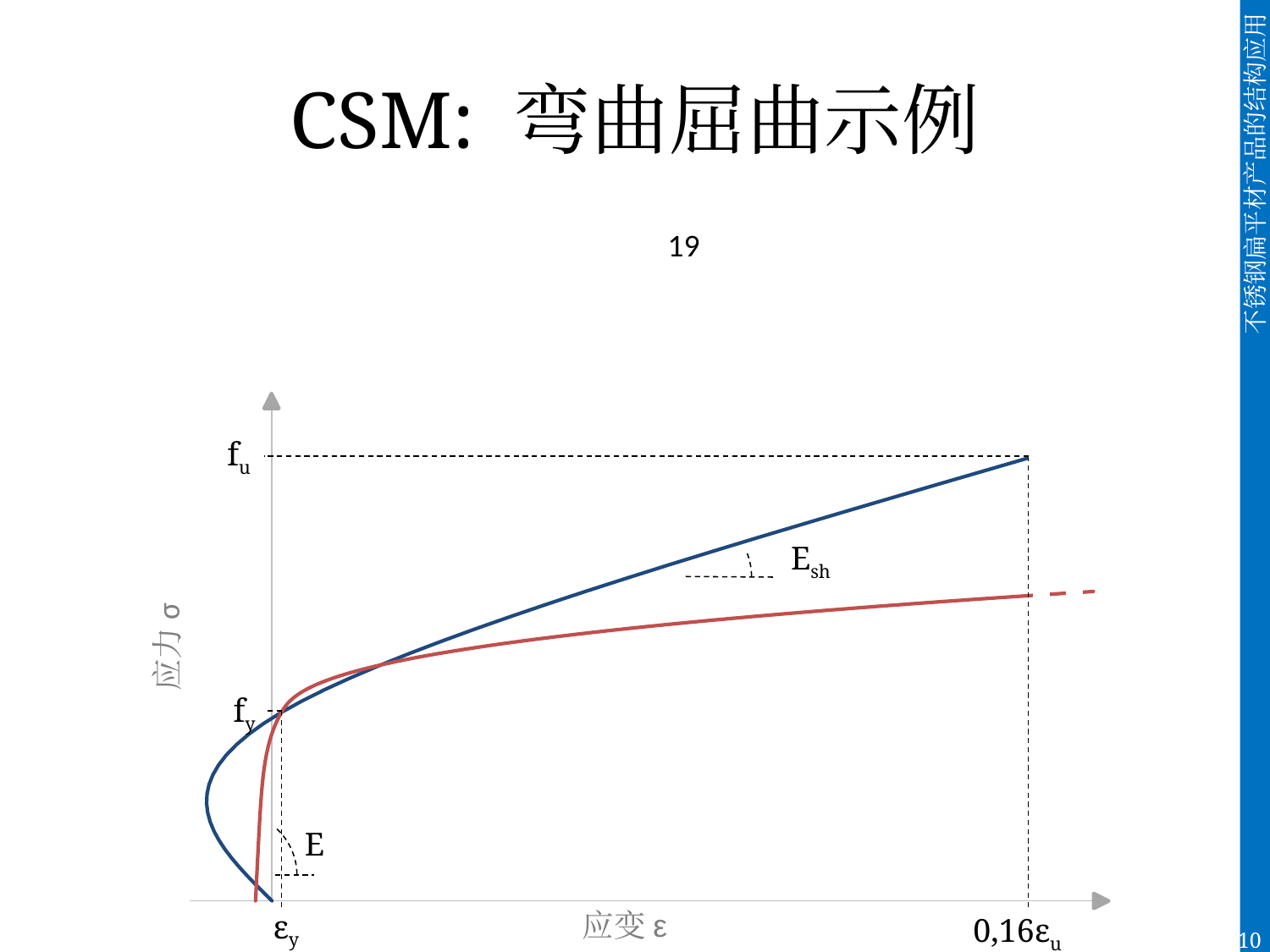
What is the label of the horizontal axis? 应变 ε What label is given to the initial slope of the blue line near the origin? E At the strain 0,16ε_u, which curve is higher, the blue one or the red one? blue How many curves are plotted on the chart? 2 What kind of chart is shown on the slide? line chart Does the stress along the blue line rise or fall as strain increases beyond ε_y? rise What label is given to the slope of the blue line above f_y? E_sh What stress level does the blue line reach at the strain 0,16ε_u? f_u At what strain does the blue line reach the stress f_y? ε_y What is the label of the vertical axis? 应力 σ